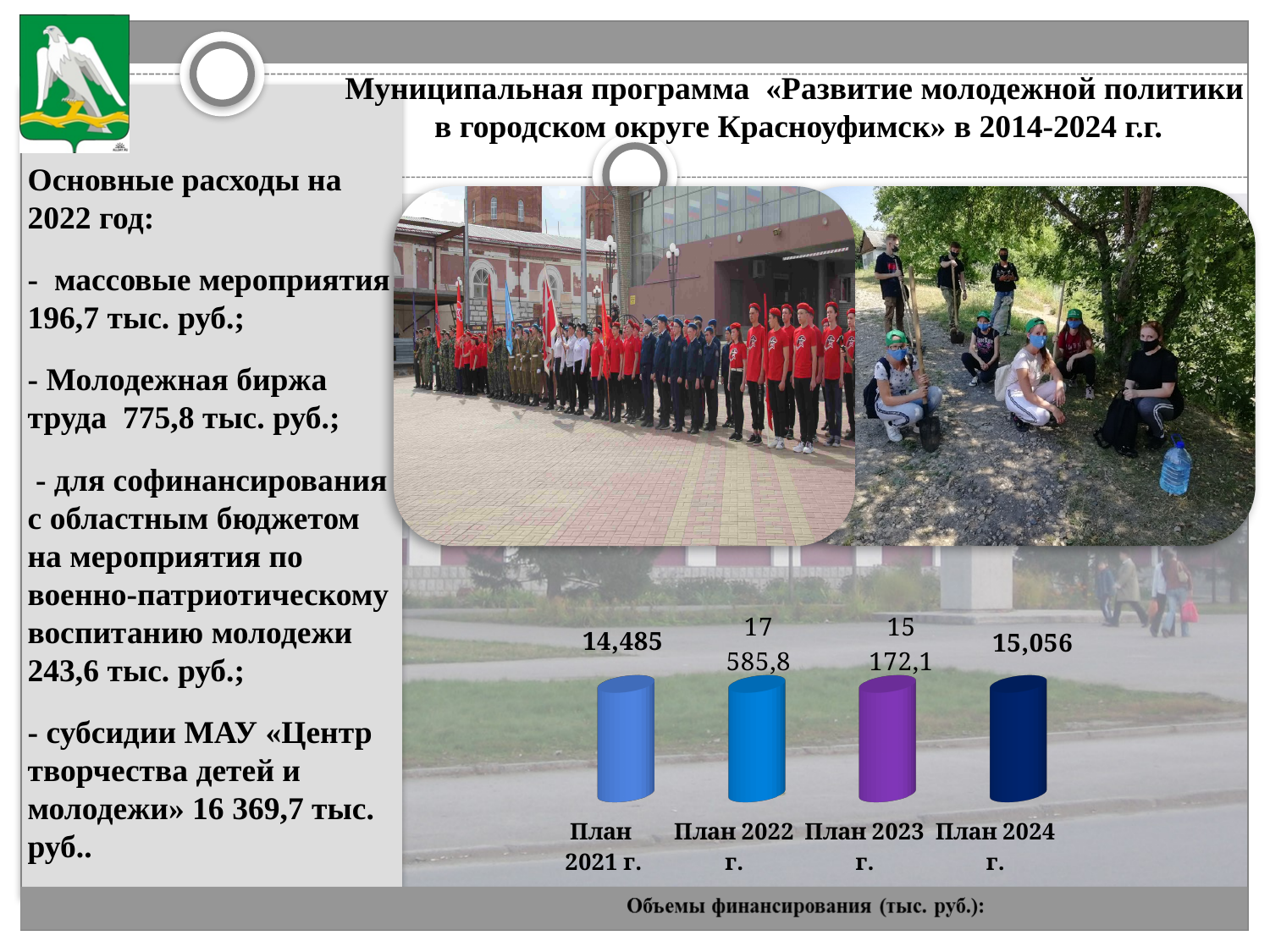
Which category has the lowest value in the chart? План 2021 г. What is the value for План 2023 г. in the chart? 15 172,1 What is the difference between the values for План 2022 г. and План 2023 г.? 2 413,7 Which is larger, the value for План 2022 г. or the value for План 2024 г.? План 2022 г. Which category has the highest value in the chart? План 2022 г. What is the value for План 2021 г. in the chart? 14,485 What caption is printed below the chart? Объемы финансирования (тыс. руб.): How many categories are shown in the chart? 4 What colour is the bar for План 2023 г.? Purple What kind of chart is shown on the slide? Bar chart What is the value for План 2022 г. in the chart? 17 585,8 What is the value for План 2024 г. in the chart? 15,056